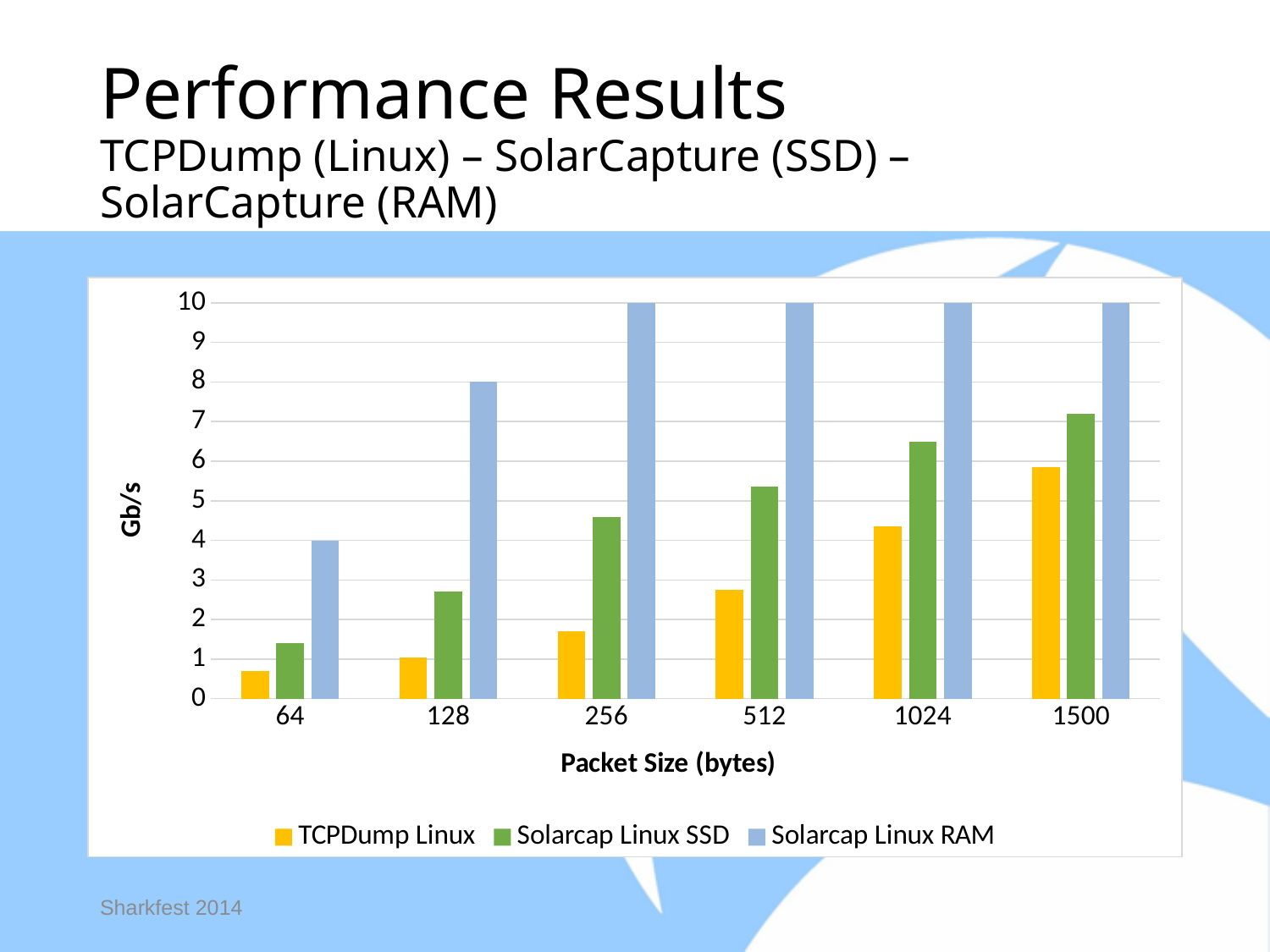
Which series has the lowest value at a packet size of 256 bytes? TCPDump Linux Which series has the highest value at a packet size of 512 bytes? Solarcap Linux RAM What kind of chart is shown on the slide? bar chart How many packet size categories are shown on the x axis? 6 Is the value for TCPDump Linux at 64 bytes greater or less than 1? less What is the value for Solarcap Linux RAM at a packet size of 64 bytes? 4 What is the value for Solarcap Linux RAM at a packet size of 128 bytes? 8 Do the TCPDump Linux values rise or fall as packet size increases along the x axis? rise What is the value for Solarcap Linux RAM at a packet size of 1500 bytes? 10 Is the value for TCPDump Linux at 1024 bytes greater or less than 4? greater How many series does the legend list? 3 Is the value for Solarcap Linux SSD at 1500 bytes greater or less than 7? greater